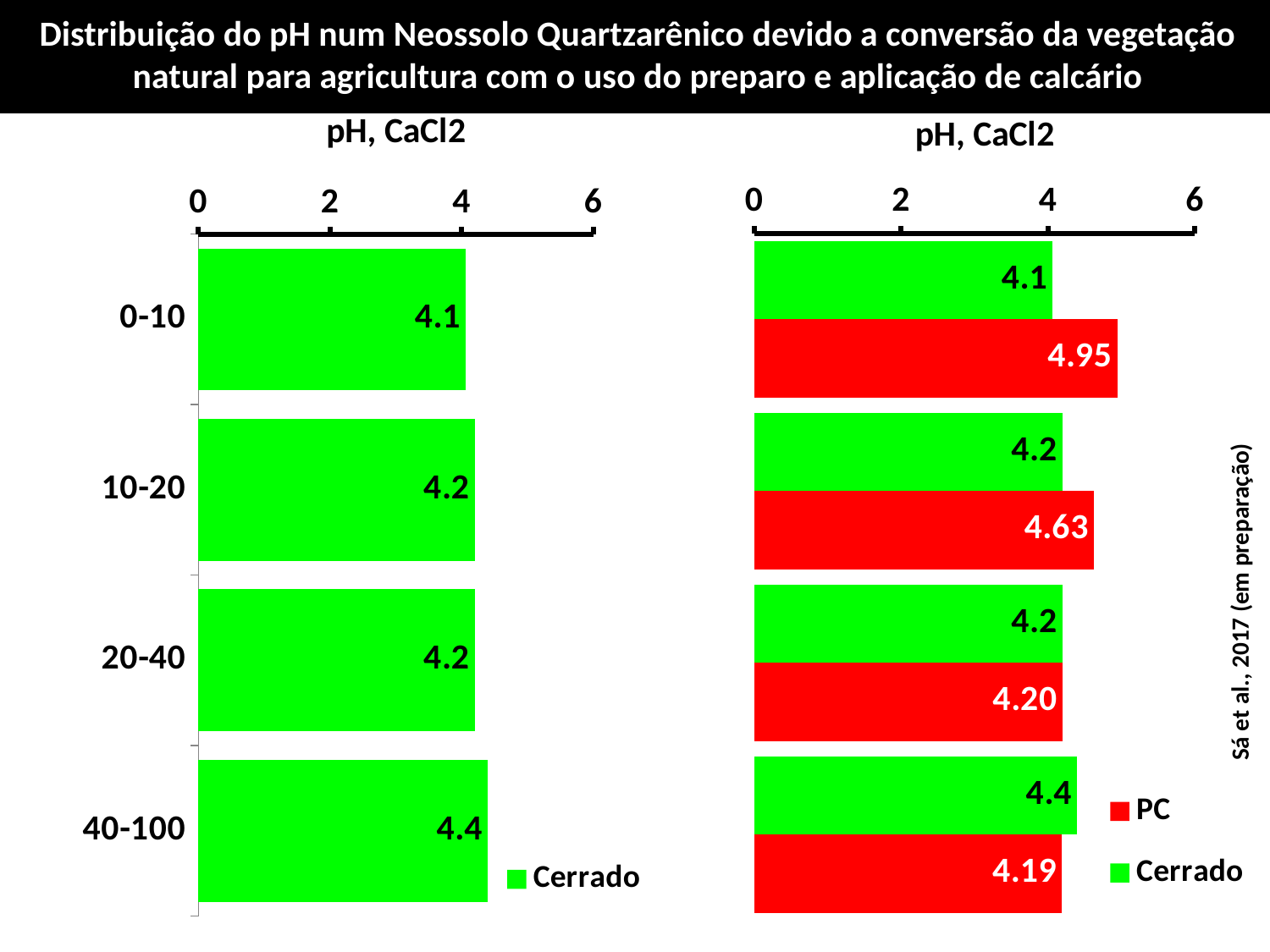
In the left chart, what is the pH value for the 0-10 depth? 4.1 In the right chart, which is larger for the 40-100 depth, PC or Cerrado? Cerrado In the left chart, which depth has the lowest pH value? 0-10 In the right chart, which depth has the highest PC value? 0-10 In the right chart, what is the Cerrado value for the 40-100 depth? 4.4 In the right chart, what is the PC value for the 10-20 depth? 4.63 In the right chart, what is the difference between the PC and Cerrado values for the 0-10 depth? 0.85 In the right chart, what is the PC value for the 0-10 depth? 4.95 In the left chart, which depth has the highest pH value? 40-100 How many series does the legend of the right chart list? 2 How many depth categories are shown in the left chart? 4 What type of chart is the right chart? Bar chart